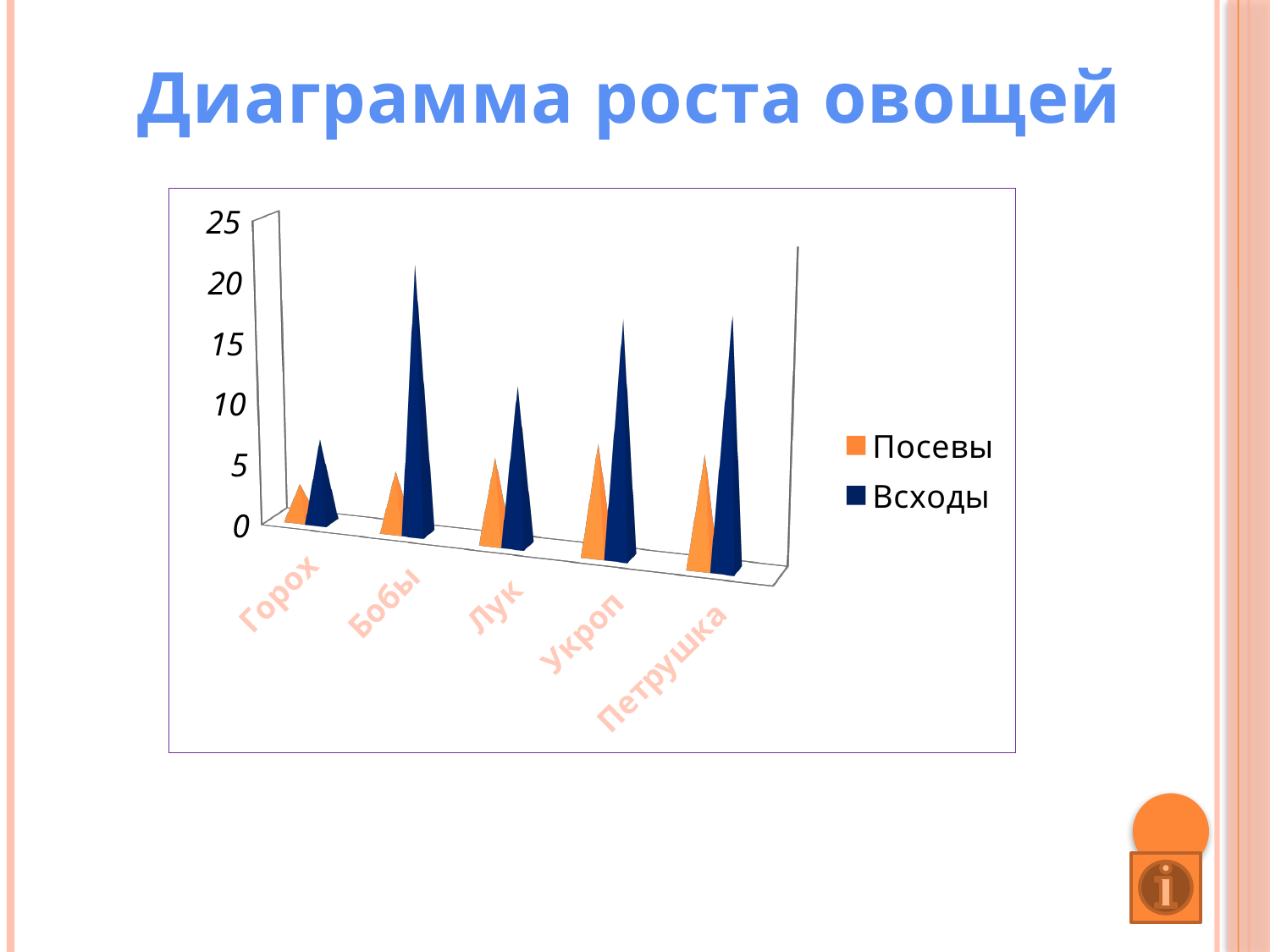
What kind of chart is shown on the slide? bar chart Which category has the lowest value for Посевы? Горох Which category has the highest value for Всходы? Бобы What is the title of the slide? Диаграмма роста овощей For Укроп, which series has the larger value, Посевы or Всходы? Всходы Is the Посевы value for Горох greater or less than 5? less How many series does the legend list? 2 Which category has the lowest value for Всходы? Горох Which is larger, the Всходы value for Бобы or for Лук? Бобы How many vegetable categories are shown on the x axis? 5 Is the Всходы value for Горох greater or less than 10? less Is the Всходы value for Бобы greater or less than 15? greater